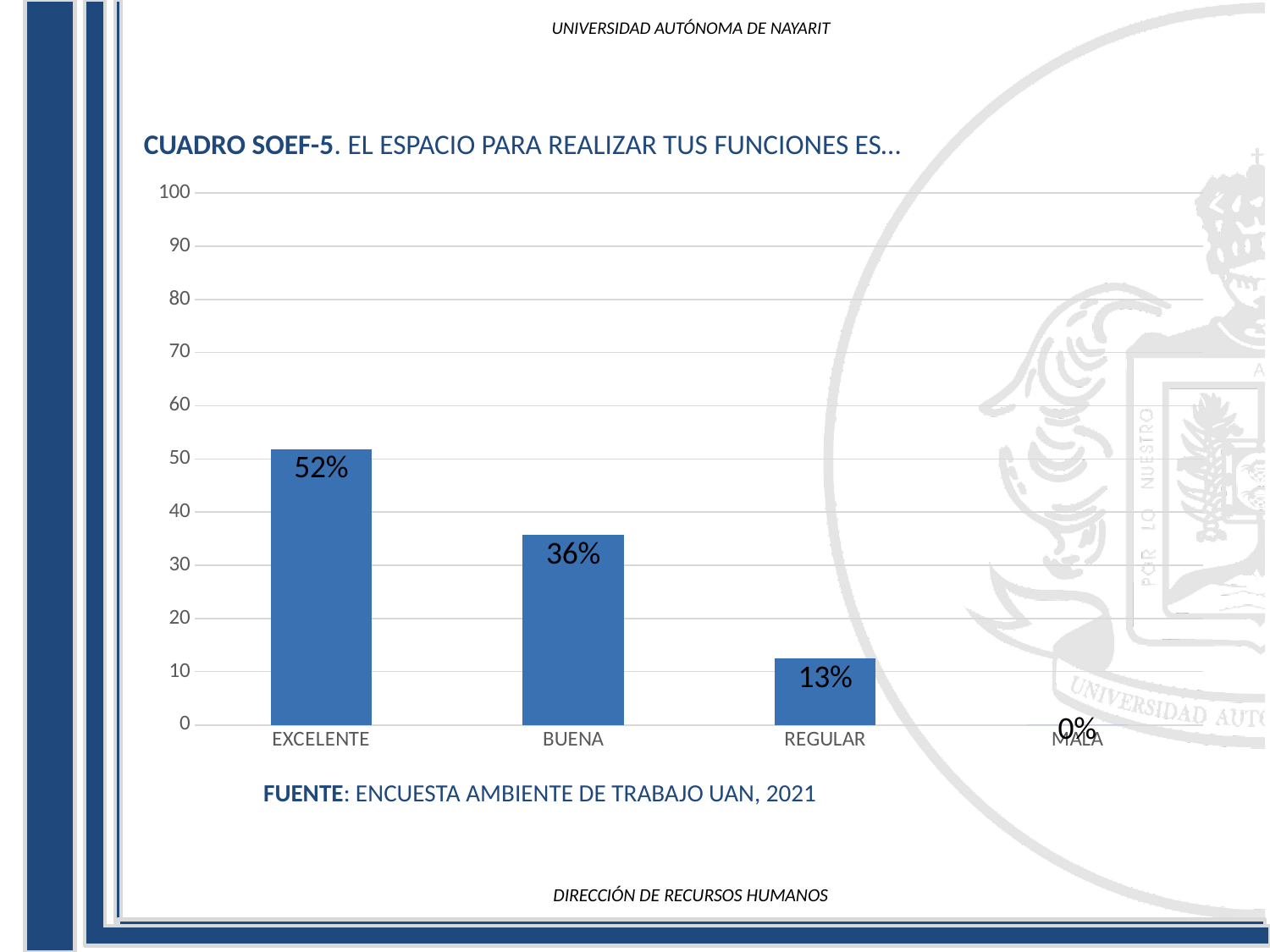
What is the value for EXCELENTE? 52% Do the values rise or fall from EXCELENTE to MALA along the x axis? fall Which category has the highest value? EXCELENTE What is the value for REGULAR? 13% What is the value for BUENA? 36% What is the value for MALA? 0% Is the value for EXCELENTE greater or less than 50? greater Which is larger, the value for BUENA or the value for REGULAR? BUENA How many categories are shown on the x axis? 4 What kind of chart is shown on the slide? bar chart Which category has the lowest value? MALA What is the difference between the values for EXCELENTE and BUENA? 16%